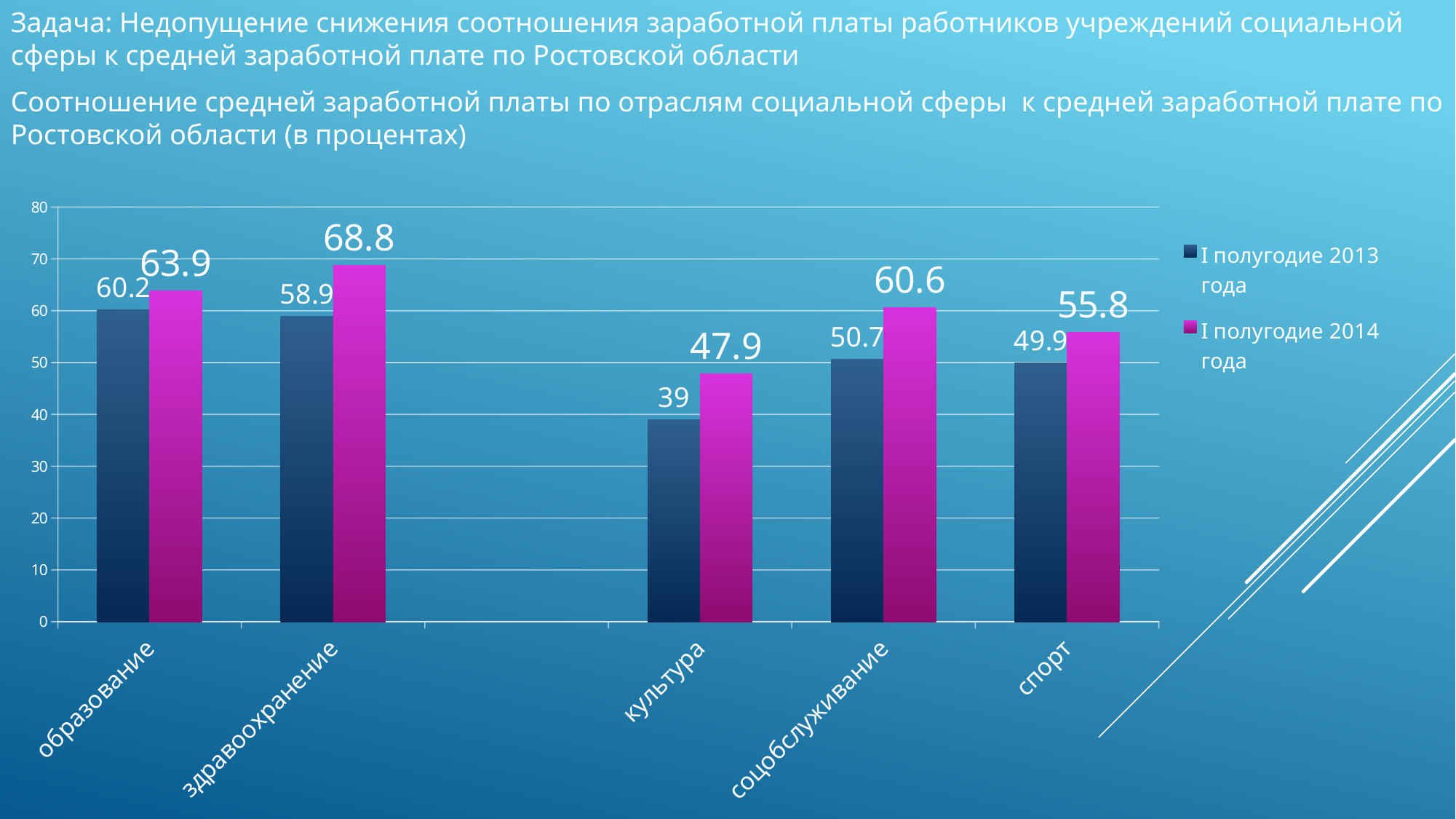
Which category has the lowest value in I полугодие 2013 года? культура How many category labels appear on the x axis? 5 What is the value for культура in I полугодие 2013 года? 39 Which colour represents I полугодие 2014 года in the chart? magenta (pink) What is the value for спорт in I полугодие 2014 года? 55.8 What is the value for соцобслуживание in I полугодие 2013 года? 50.7 What is the difference between the I полугодие 2014 года and I полугодие 2013 года values for здравоохранение? 9.9 Which category has the highest value in I полугодие 2014 года? здравоохранение What is the value for здравоохранение in I полугодие 2014 года? 68.8 What kind of chart is shown on the slide? bar chart How many series does the legend list? 2 Which is larger: the I полугодие 2013 года value for образование or for здравоохранение? образование